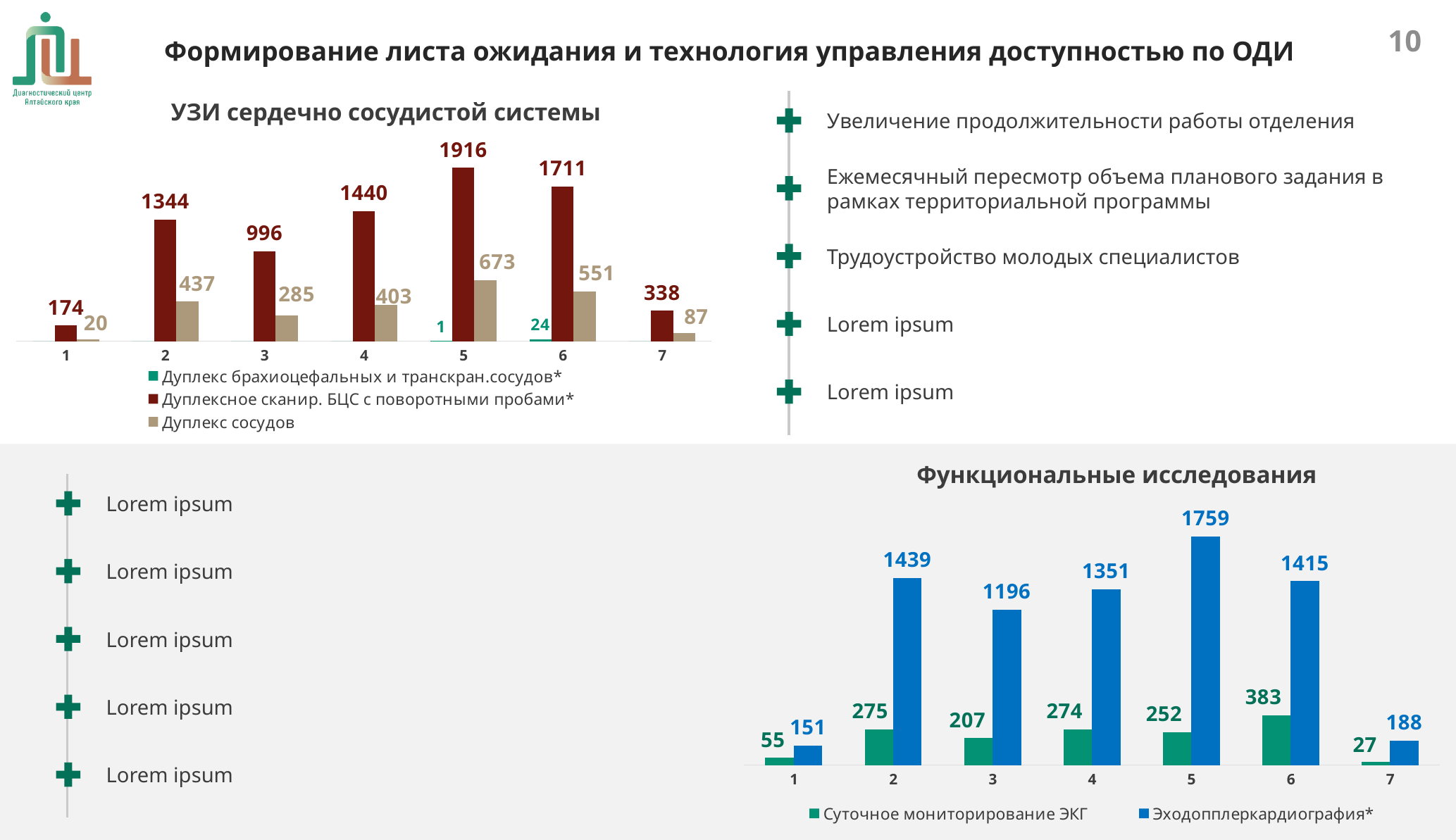
What type of chart is 'Функциональные исследования'? Bar chart In the 'УЗИ сердечно сосудистой системы' chart, what is the value of 'Дуплекс сосудов' for category 2? 437 In the 'Функциональные исследования' chart, which category has the highest value for 'Суточное мониторирование ЭКГ'? 6 In the 'УЗИ сердечно сосудистой системы' chart, how many series does the legend list? 3 In the 'УЗИ сердечно сосудистой системы' chart, what is the value of 'Дуплексное сканир. БЦС с поворотными пробами*' for category 5? 1916 In the 'Функциональные исследования' chart, how many categories are shown on the x axis? 7 In the 'УЗИ сердечно сосудистой системы' chart, what is the difference between the 'Дуплекс сосудов' values for categories 5 and 6? 122 In the 'Функциональные исследования' chart, what is the difference between 'Эходопплеркардиография*' and 'Суточное мониторирование ЭКГ' for category 5? 1507 In the 'УЗИ сердечно сосудистой системы' chart, what is the value of 'Дуплекс брахиоцефальных и транскран.сосудов*' for category 6? 24 In the 'Функциональные исследования' chart, what is the value of 'Эходопплеркардиография*' for category 3? 1196 In the 'Функциональные исследования' chart, which is larger: 'Эходопплеркардиография*' for category 2 or for category 4? Category 2 In the 'УЗИ сердечно сосудистой системы' chart, which category has the lowest value for 'Дуплексное сканир. БЦС с поворотными пробами*'? 1